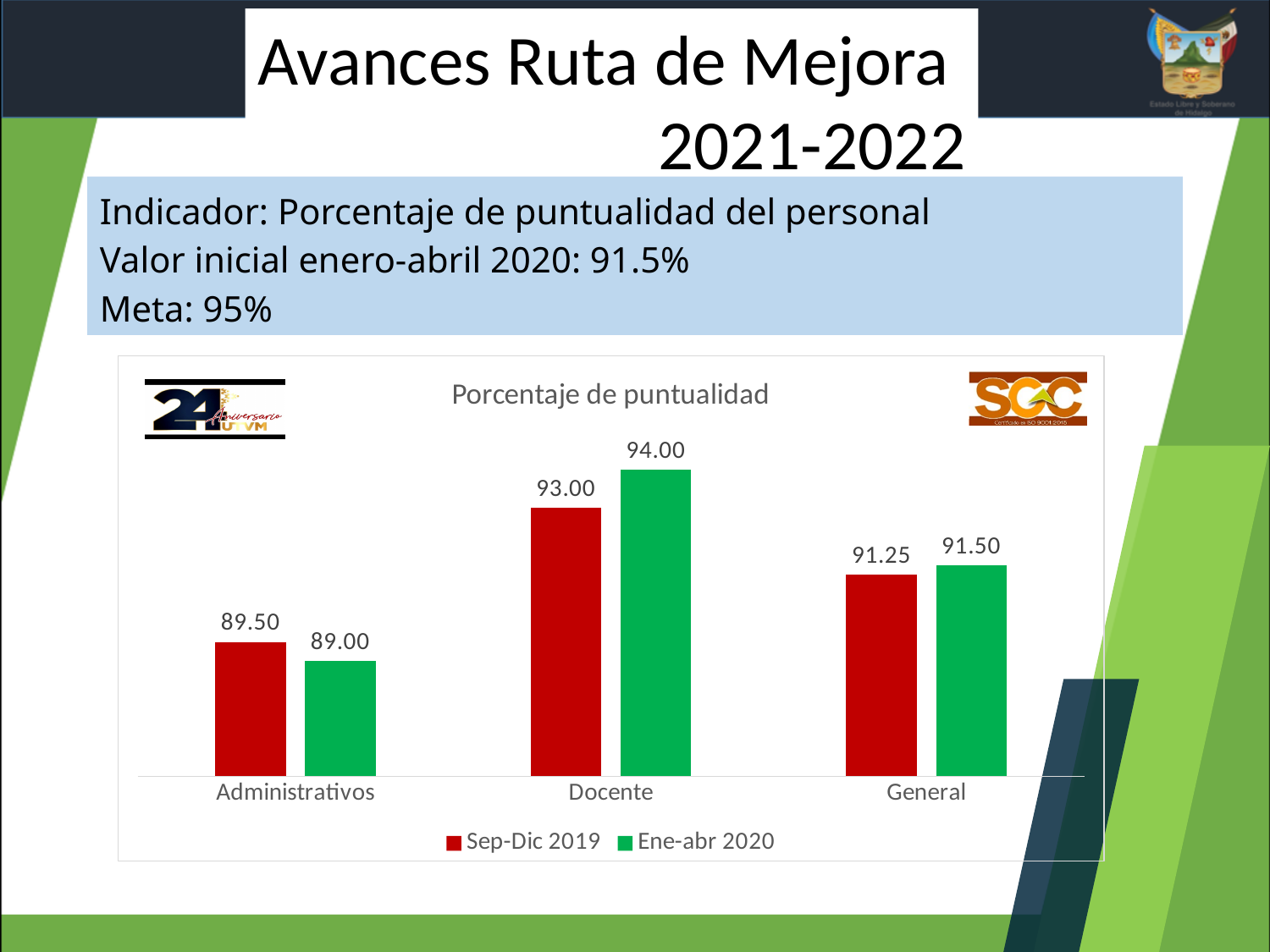
What is the value for General in the Ene-abr 2020 series? 91.50 Which category has the highest value in the Sep-Dic 2019 series? Docente For Administrativos, which series has the larger value, Sep-Dic 2019 or Ene-abr 2020? Sep-Dic 2019 How many categories are shown on the x axis? 3 Which category has the lowest value in the Ene-abr 2020 series? Administrativos What is the title of the chart? Porcentaje de puntualidad What is the value for Administrativos in the Sep-Dic 2019 series? 89.50 What is the difference between the Ene-abr 2020 and Sep-Dic 2019 values for Docente? 1.00 What kind of chart is shown on the slide? Bar chart How many series does the legend list? 2 What is the difference between the Sep-Dic 2019 and Ene-abr 2020 values for Administrativos? 0.50 What is the value for Docente in the Ene-abr 2020 series? 94.00